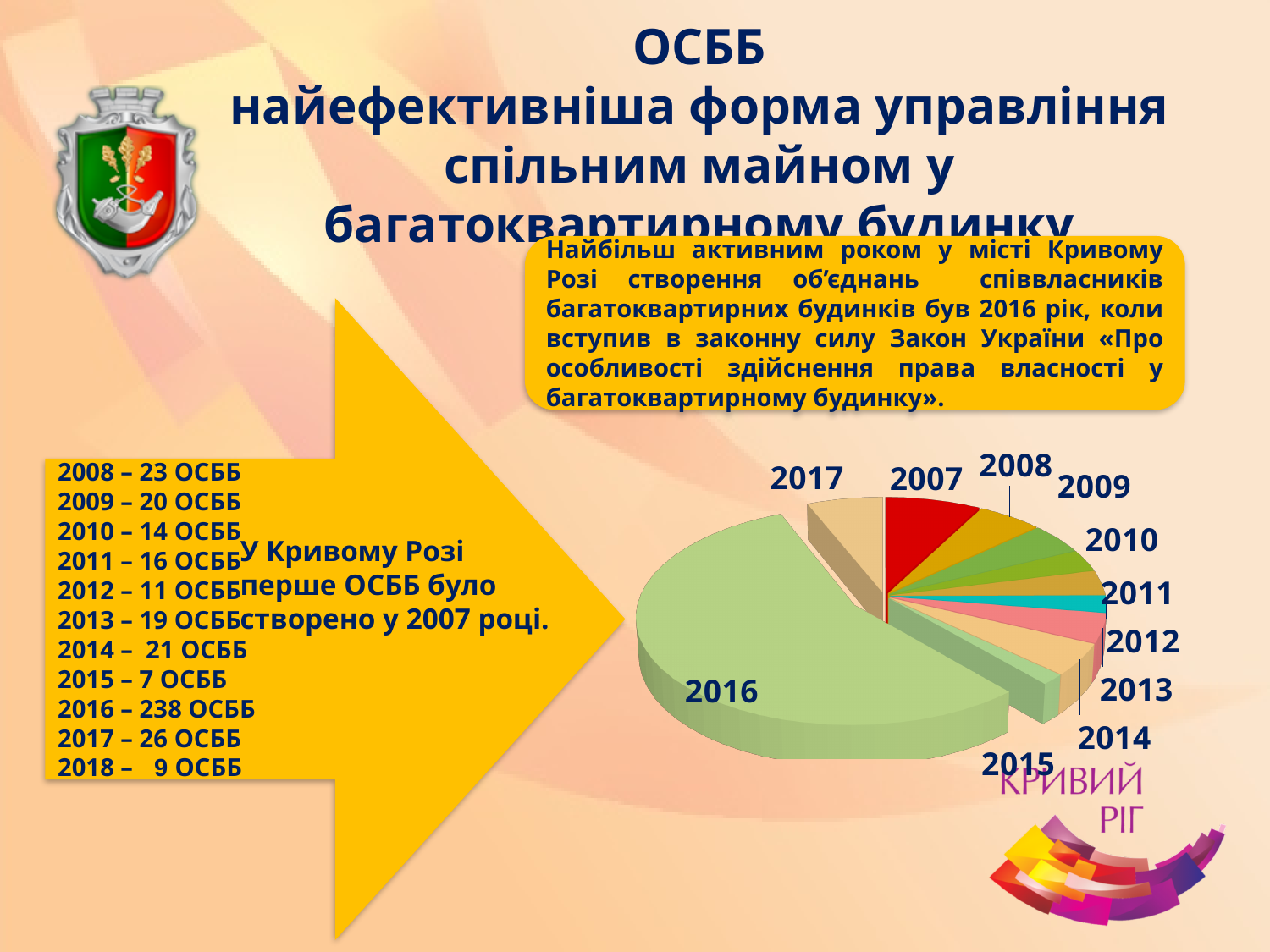
Which year has the largest slice in the pie chart? 2016 Which year has the smallest slice in the pie chart? 2015 What is the earliest year labelled on the pie chart? 2007 Which year is represented by the large light green slice of the pie chart? 2016 According to the slide, how many ОСББ were created in 2016? 238 What is the difference between the number of ОСББ created in 2016 and in 2017? 212 What kind of chart is shown on the slide? pie chart Which slice is larger, 2007 or 2016? 2016 Which slice is larger, 2016 or 2017? 2016 According to the slide, how many ОСББ were created in 2008? 23 How many slices (years) does the pie chart have? 11